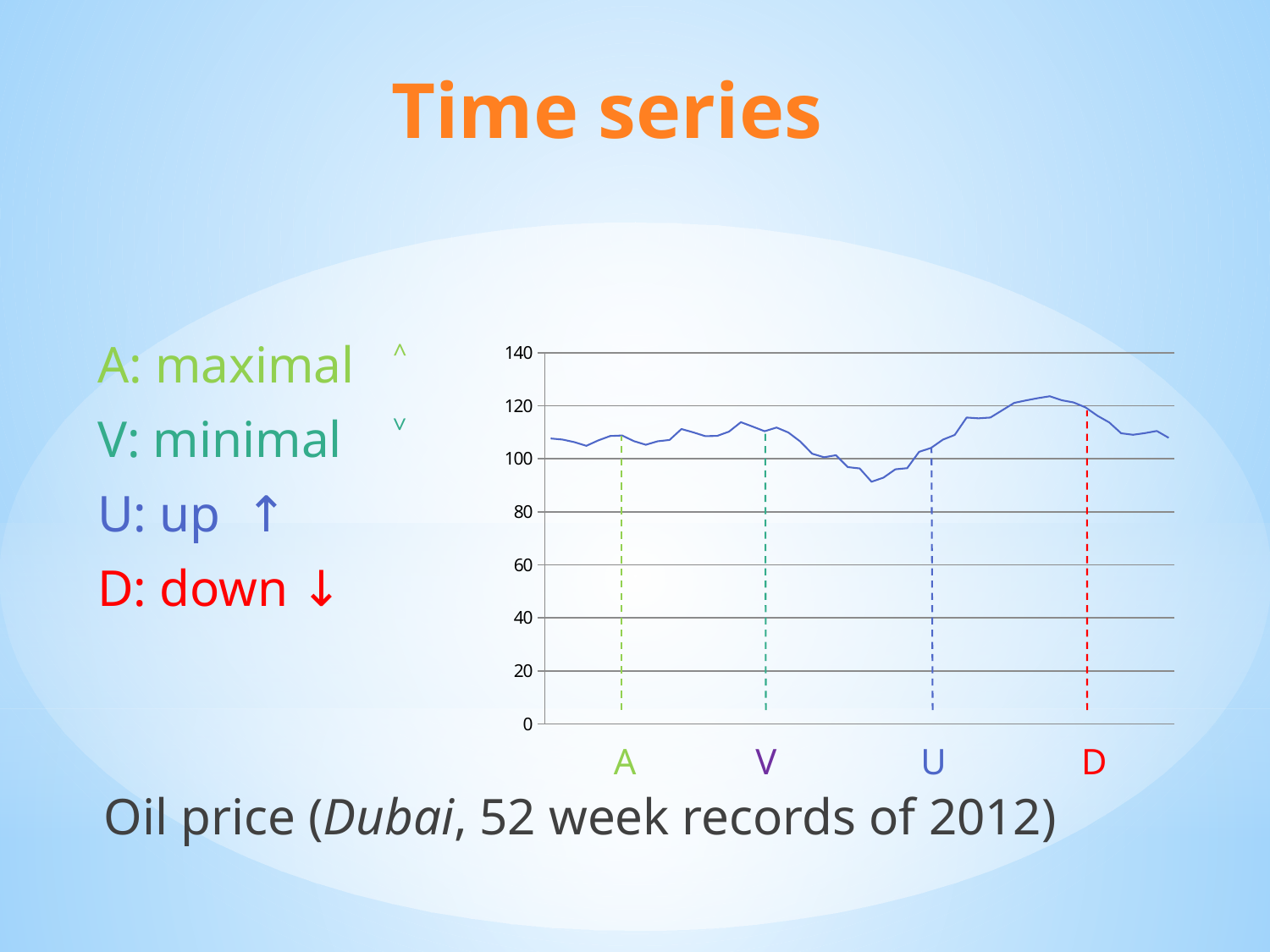
Is the value of the line at marker V greater or less than 100? greater How many labelled marker positions (dashed vertical lines) are shown along the x axis of the chart? 4 What are the labels of the four marked positions along the x axis, from left to right? A, V, U, D Is the value of the line at marker A greater or less than 100? greater Which is larger, the value of the line at marker D or at marker U? D What kind of chart is shown on the slide? line chart Does the line rise or fall between marker V and the lowest point of the series? fall Is the lowest point of the line greater or less than 100? less Does the line rise or fall between marker U and marker D? rise What is the highest value shown on the chart's y axis? 140